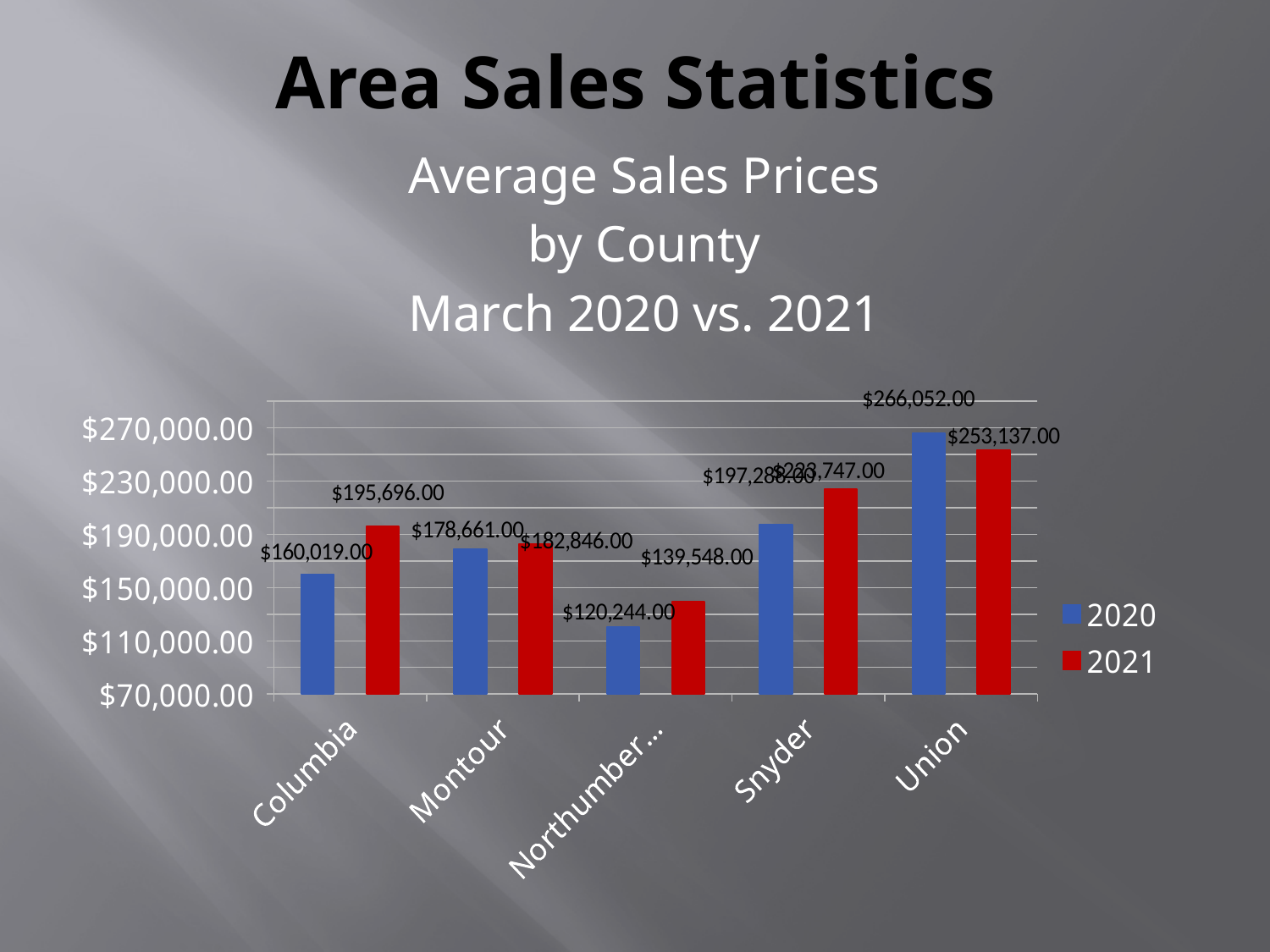
Is the 2021 value for Snyder greater or less than $190,000.00? greater Which county has the highest 2020 average sales price? Union What is the 2020 average sales price for Union? $266,052.00 For Montour, which year has the higher average sales price, 2020 or 2021? 2021 What kind of chart is shown on the slide? bar chart By how much did Columbia's average sales price increase from 2020 to 2021? $35,677.00 What is the 2020 average sales price for Montour? $178,661.00 What is the 2021 average sales price for Union? $253,137.00 What is the 2021 average sales price for Columbia? $195,696.00 What is the 2020 average sales price for Columbia? $160,019.00 How many counties are shown on the x axis? 5 How many series does the legend list? 2